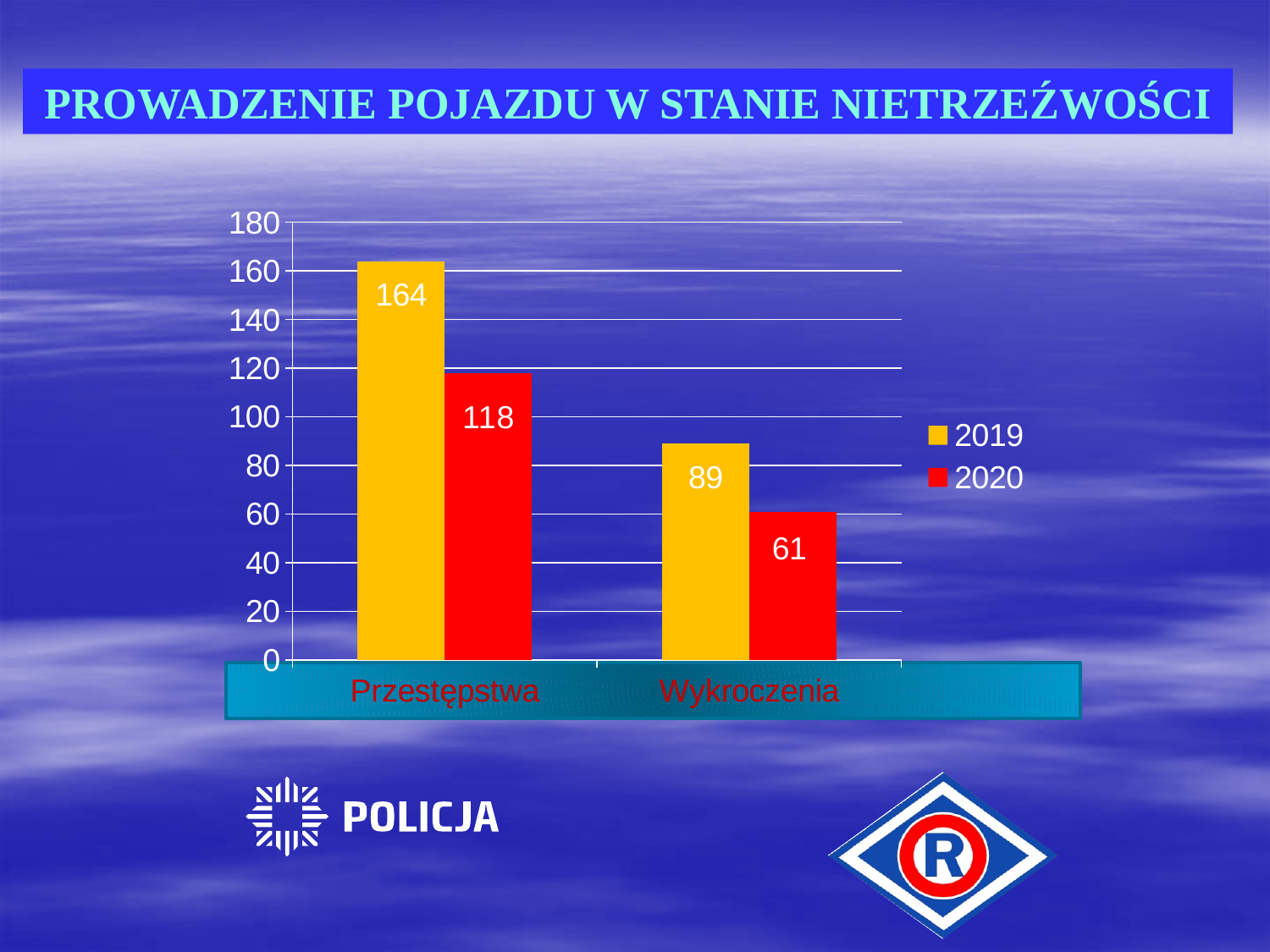
What kind of chart is shown on the slide? bar chart How many categories are shown on the x axis? 2 Which is larger: the 2020 value for Przestępstwa or the 2019 value for Wykroczenia? 2020 value for Przestępstwa What is the value for Przestępstwa in 2019? 164 How many series does the legend list? 2 What is the value for Przestępstwa in 2020? 118 Which category has the highest value in 2019? Przestępstwa What is the difference between the 2019 and 2020 values for Przestępstwa? 46 Which category has the lowest value in 2020? Wykroczenia Which colour represents the 2020 series? red What is the difference between the 2019 and 2020 values for Wykroczenia? 28 What is the value for Wykroczenia in 2020? 61